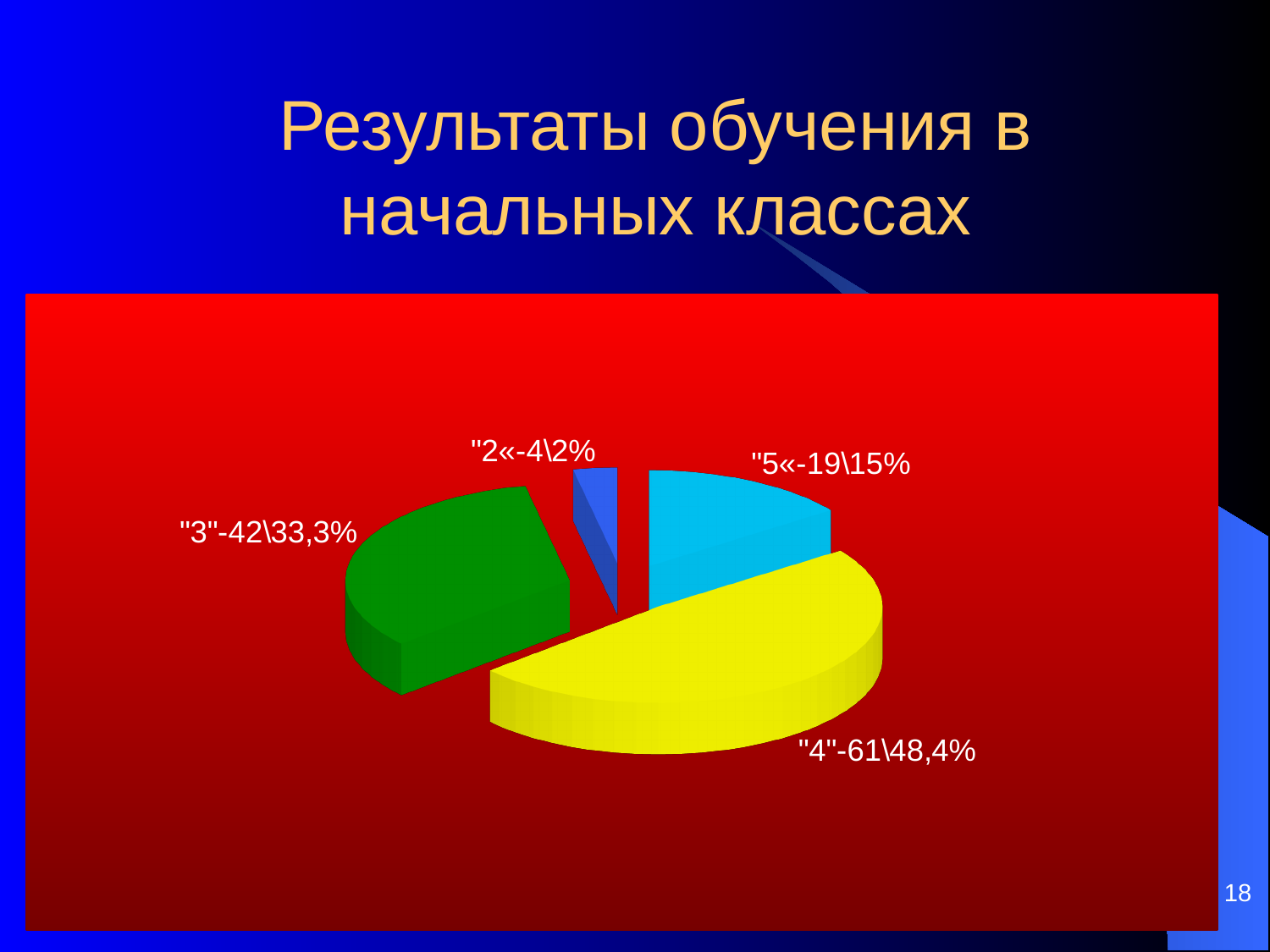
What number is shown for the "2" slice? 4 What is the difference between the numbers shown for the "4" slice and the "3" slice? 19 What percentage share is shown for the "5" slice? 15% What colour is the "4" slice of the pie chart? yellow How many slices does the pie chart have? 4 Which slice is larger, "5" or "3"? "3" What kind of chart is shown on the slide? pie chart Which slice has the largest share of the pie? "4" What number is shown for the "3" slice? 42 Which slice has the smallest share of the pie? "2" What is the title of the slide containing the chart? Результаты обучения в начальных классах What percentage share is shown for the "4" slice? 48,4%